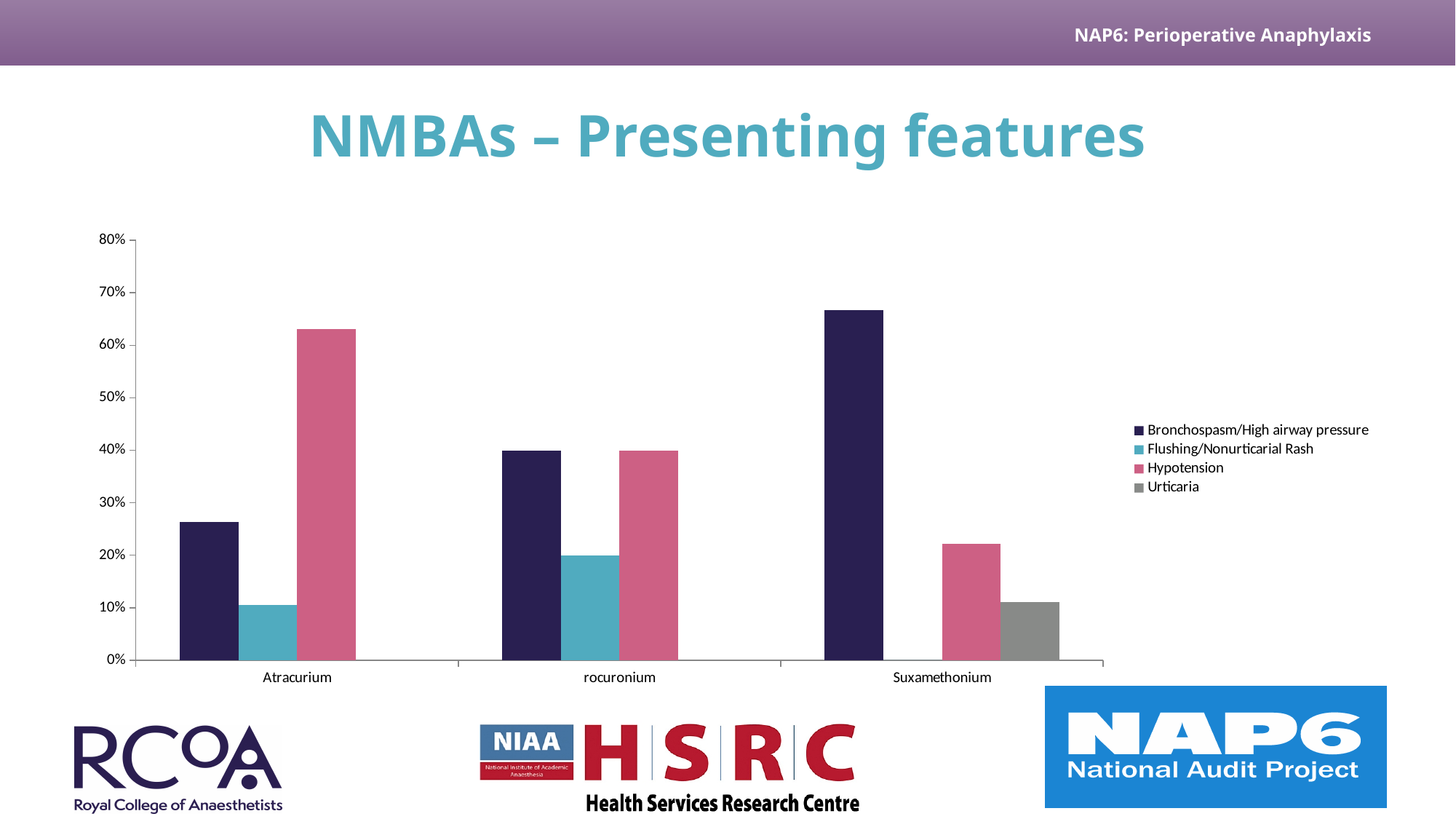
What kind of chart is shown on the slide? bar chart Which drug is the only one with an Urticaria bar? Suxamethonium For Atracurium, which is larger: Hypotension or Bronchospasm/High airway pressure? Hypotension Is the Flushing/Nonurticarial Rash value for Atracurium greater or less than 20%? less Which drug has the highest Bronchospasm/High airway pressure value? Suxamethonium Is the Bronchospasm/High airway pressure value for Suxamethonium greater or less than 60%? greater Which drug has the lowest Hypotension value? Suxamethonium What is the title of the slide containing the chart? NMBAs – Presenting features Is the Hypotension value for Atracurium greater or less than 60%? greater How many series does the legend list? 4 How many drug categories are shown on the x axis? 3